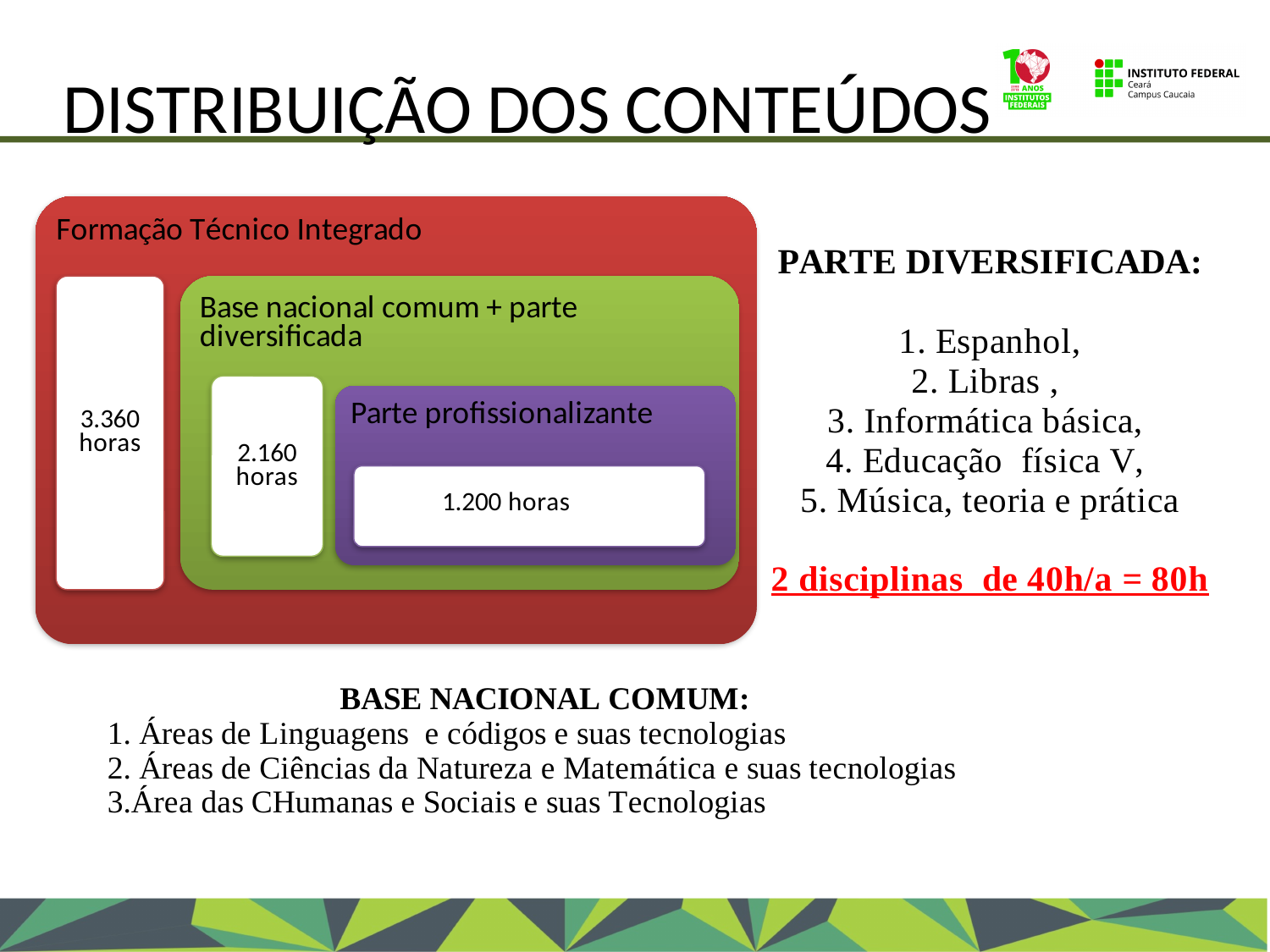
How many labelled sections with hour values does the nested box diagram contain? 3 In the nested box diagram, what is the difference in hours between Base nacional comum + parte diversificada and Parte profissionalizante? 960 horas In the nested box diagram, what is the difference in hours between Formação Técnico Integrado and Base nacional comum + parte diversificada? 1.200 horas What colour is the outermost box (Formação Técnico Integrado) in the nested diagram? Red In the nested box diagram, which section has the smallest number of hours? Parte profissionalizante In the nested box diagram, which has more hours: Base nacional comum + parte diversificada or Parte profissionalizante? Base nacional comum + parte diversificada In the nested box diagram, which section has the largest number of hours? Formação Técnico Integrado In the nested box diagram, how many hours are shown for Formação Técnico Integrado? 3.360 horas In the nested box diagram, how many hours are shown for Parte profissionalizante? 1.200 horas What colour is the Parte profissionalizante box in the nested diagram? Purple In the nested box diagram, how many hours are shown for Base nacional comum + parte diversificada? 2.160 horas